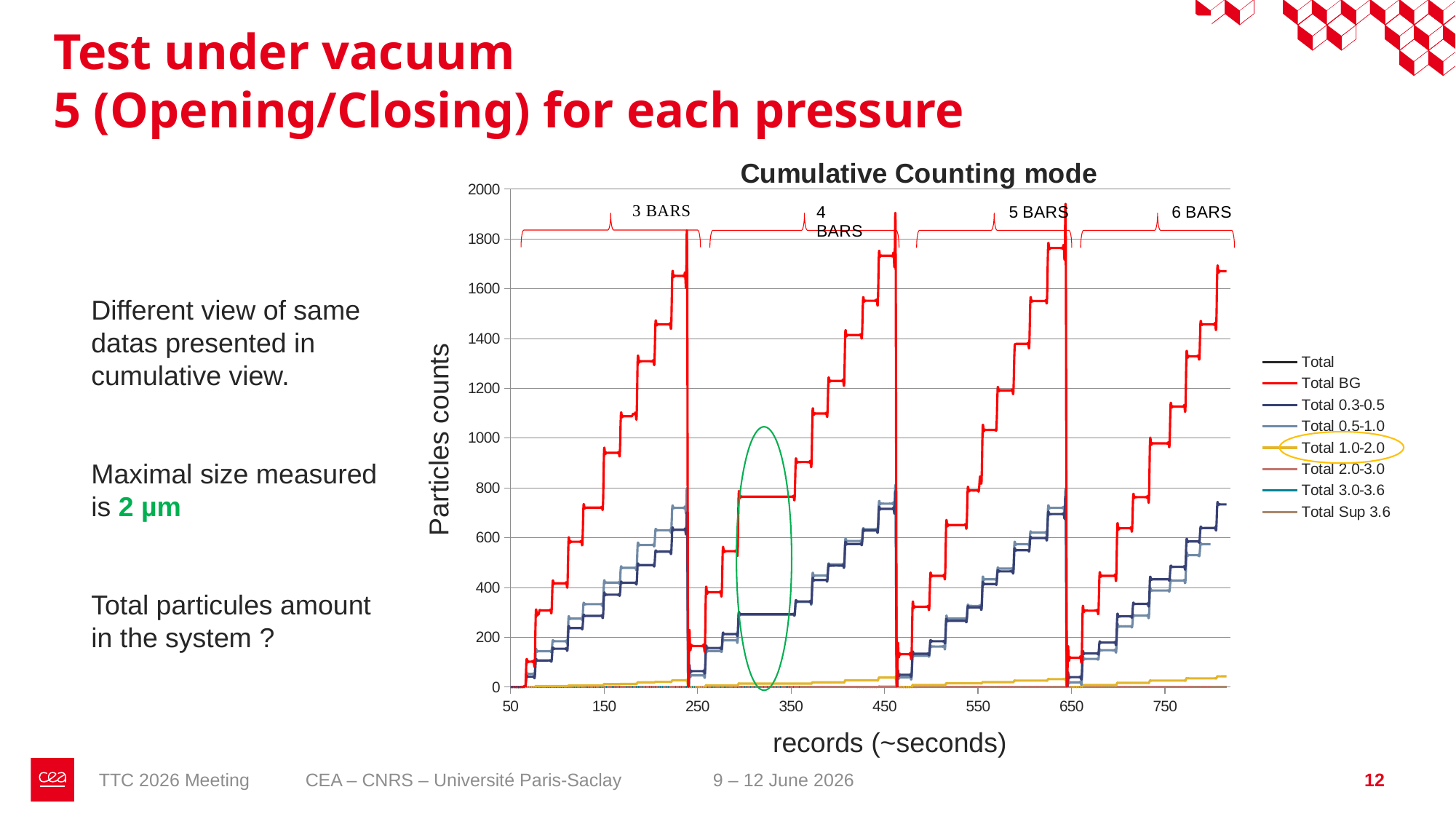
How many series does the chart legend list? 8 Which series is higher at the end of the 5 BARS segment, Total BG or Total 0.3-0.5? Total BG Is the peak value of Total BG in the 4 BARS segment greater or less than 1600? greater Within each pressure segment, does the Total BG series rise or fall along the x axis? rise Is the peak value of Total BG in the 3 BARS segment greater or less than 1400? greater Is the value of Total 1.0-2.0 at the right end of the chart greater or less than 200? less Which legend entry is circled in yellow? Total 1.0-2.0 What is the title of the chart? Cumulative Counting mode What is the label of the x axis? records (~seconds) Which series reaches the highest particle counts in the chart? Total BG What kind of chart is shown on the slide? line chart How many pressure segments (BARS labels) are marked above the chart? 4